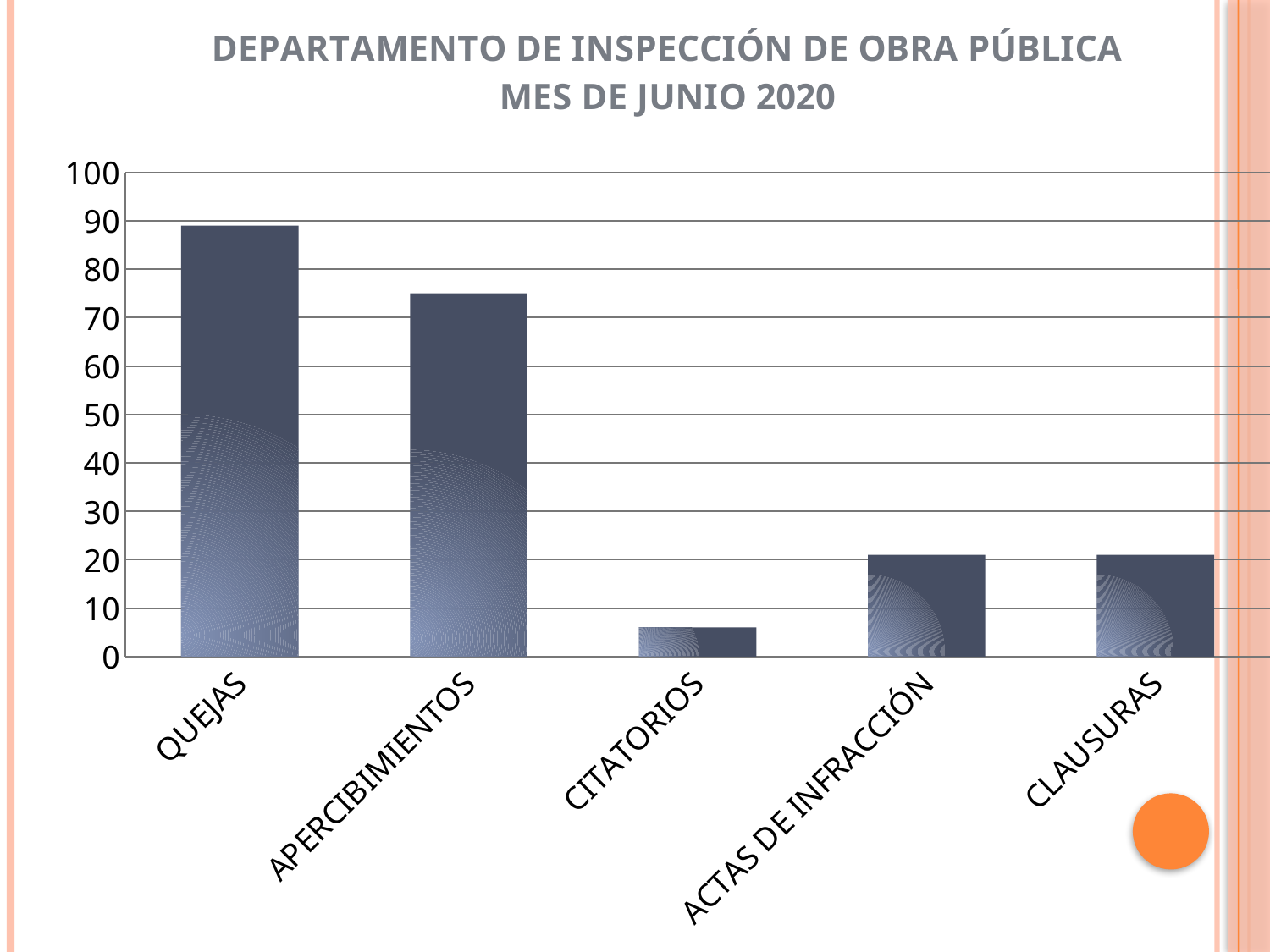
Which category has the highest value? QUEJAS Is the value for CITATORIOS greater or less than 10? less Is the value for APERCIBIMIENTOS greater or less than 70? greater Which month and year does the chart title say the data is for? JUNIO 2020 Is the value for ACTAS DE INFRACCIÓN greater or less than 30? less Which is larger, the value for CITATORIOS or the value for CLAUSURAS? CLAUSURAS What kind of chart is shown on the slide? bar chart Which is larger, the value for QUEJAS or the value for APERCIBIMIENTOS? QUEJAS Do the values rise or fall across the first three categories, from QUEJAS to CITATORIOS? fall Which category has the lowest value? CITATORIOS How many categories are plotted on the x axis? 5